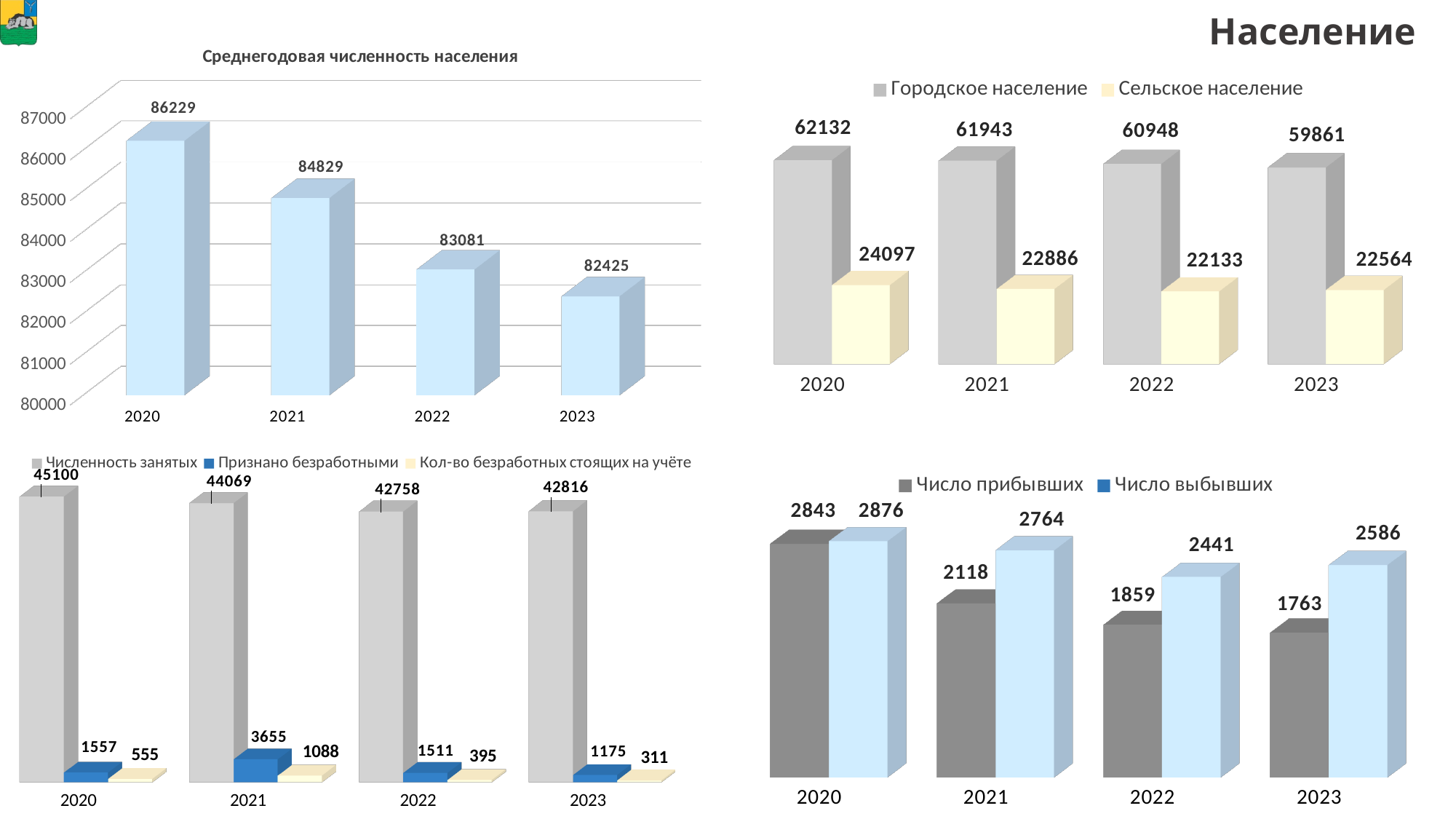
In the bottom-left chart, what is the value of 'Признано безработными' for 2021? 3655 In the bottom-left chart, how many series does the legend list? 3 In the chart titled 'Среднегодовая численность населения', which year has the lowest value? 2023 In the bottom-left chart, which year has the lowest value for 'Кол-во безработных стоящих на учёте'? 2023 In the chart titled 'Среднегодовая численность населения', what is the difference between the 2020 and 2023 values? 3804 In the top-right chart, which year has the highest value for 'Сельское население'? 2020 In the bottom-right chart, what is the difference between 'Число выбывших' and 'Число прибывших' for 2023? 823 In the top-right chart, what is the value of 'Городское население' for 2023? 59861 In the bottom-right chart, which is larger for 2022: 'Число прибывших' or 'Число выбывших'? Число выбывших In the chart titled 'Среднегодовая численность населения', do the values rise or fall from 2020 to 2023? fall In the top-right chart, what is the value of 'Сельское население' for 2022? 22133 In the chart titled 'Среднегодовая численность населения', what is the value for 2021? 84829